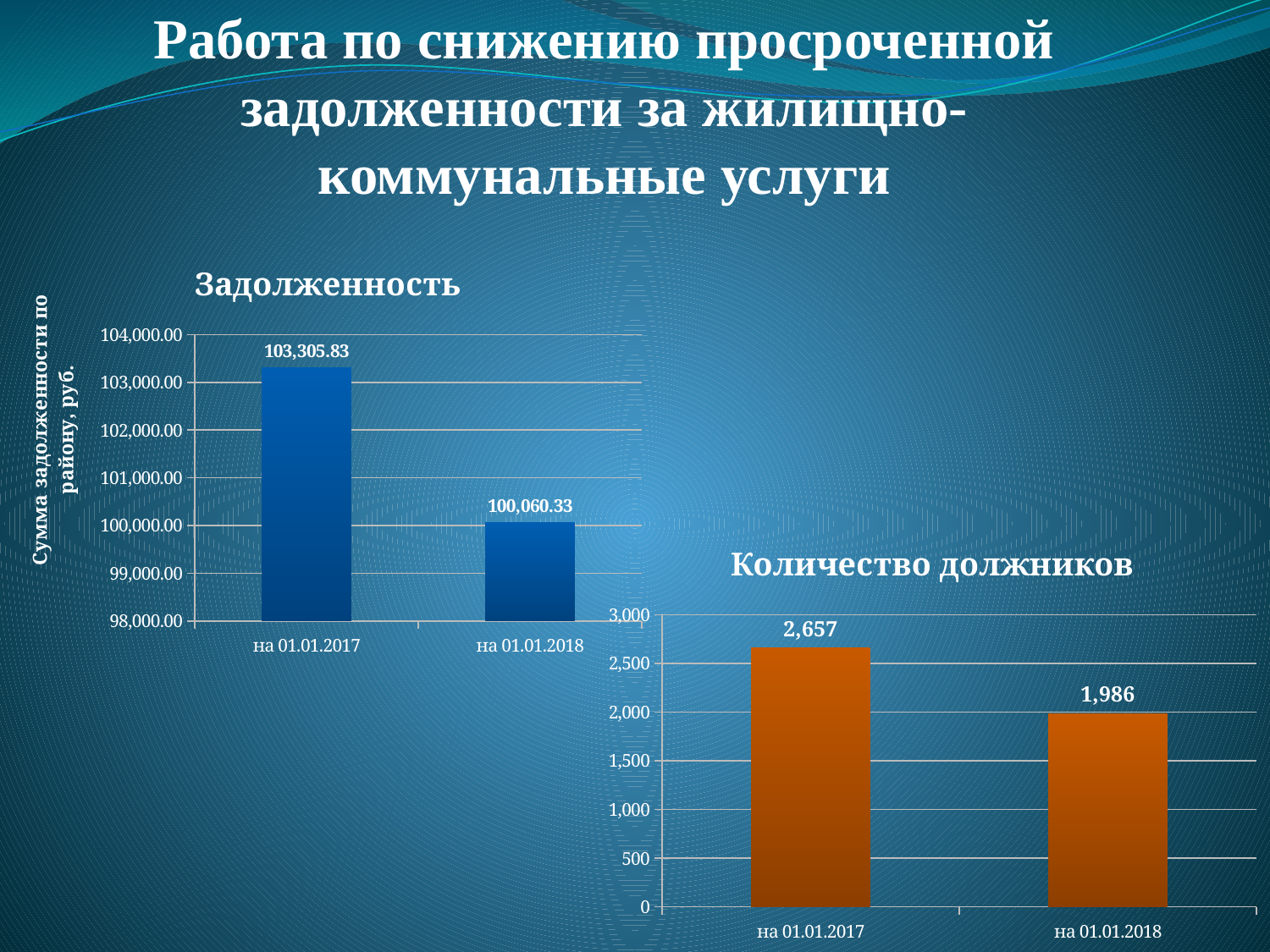
In the 'Количество должников' chart, is the value for на 01.01.2018 greater or less than 2,000? less In the 'Задолженность' chart, do the values rise or fall from на 01.01.2017 to на 01.01.2018? fall In the 'Задолженность' chart, what is the difference between the values for на 01.01.2017 and на 01.01.2018? 3,245.50 In the 'Количество должников' chart, which category has the lowest value? на 01.01.2018 In the 'Задолженность' chart, what is the value for на 01.01.2018? 100,060.33 How many categories are shown in the 'Количество должников' chart? 2 In the 'Количество должников' chart, what is the value for на 01.01.2017? 2,657 In the 'Задолженность' chart, what is the value for на 01.01.2017? 103,305.83 What type of chart is the 'Задолженность' chart? bar chart In the 'Задолженность' chart, which category has the highest value? на 01.01.2017 In the 'Количество должников' chart, by how much did the value decrease from на 01.01.2017 to на 01.01.2018? 671 In the 'Количество должников' chart, what is the value for на 01.01.2018? 1,986